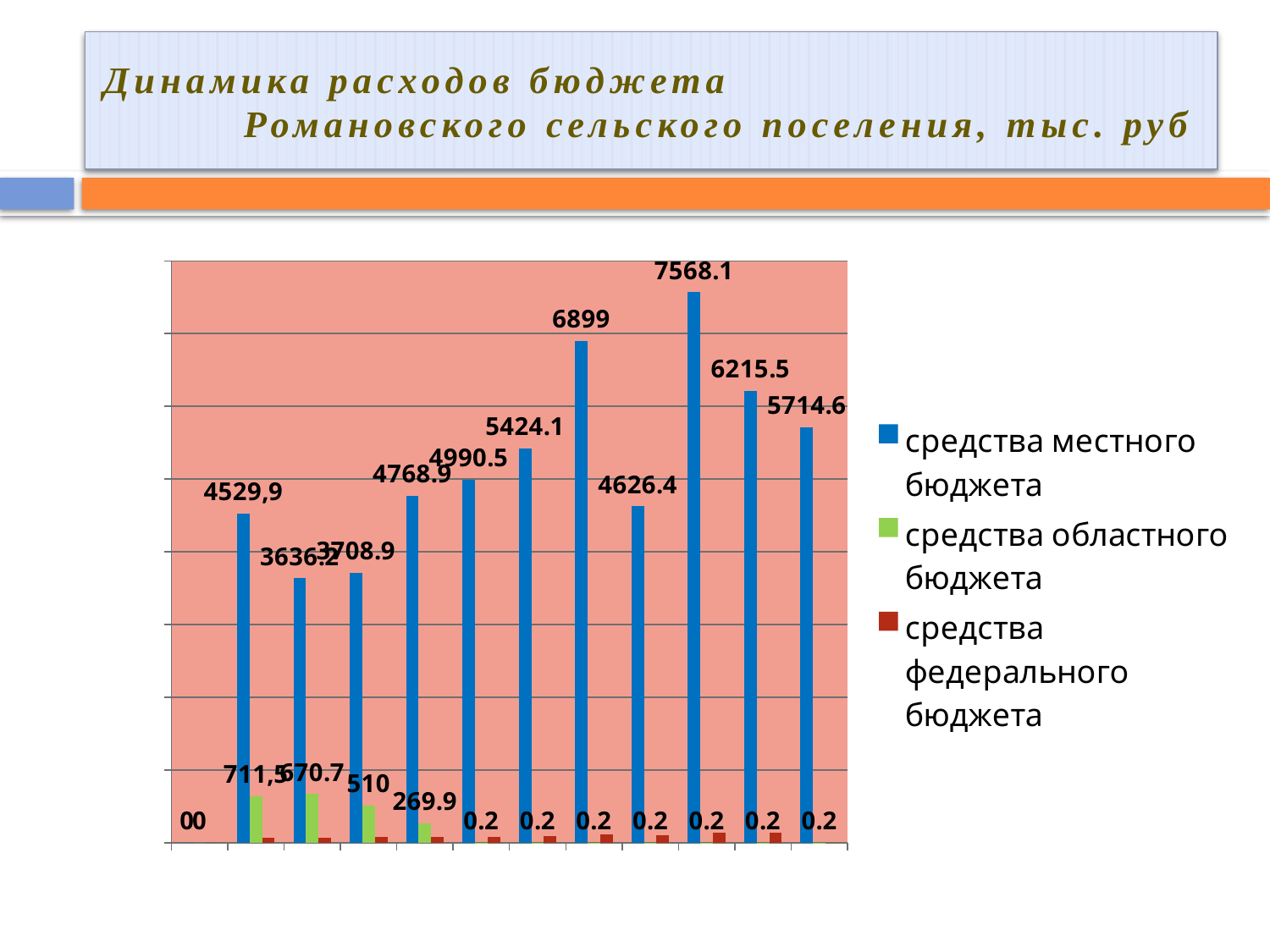
What is the value labelled on the first (leftmost) green bar for 'средства областного бюджета'? 711,5 What is the value labelled on the first (leftmost) blue bar for 'средства местного бюджета'? 4529,9 What is the difference between the highest blue bar (7568.1) and the blue bar immediately to its right (6215.5)? 1352.6 Which is larger for 'средства местного бюджета': the bar labelled 6899 or the bar labelled 6215.5? 6899 What is the value labelled on the last (rightmost) blue bar for 'средства местного бюджета'? 5714.6 Which series is shown in blue according to the legend? средства местного бюджета What is the lowest value labelled for the series 'средства местного бюджета'? 3636.2 How many series does the legend list? 3 What kind of chart is shown on the slide? bar chart What value is labelled on the last (rightmost) green bar for 'средства областного бюджета'? 0.2 How many blue bars (средства местного бюджета) are plotted in the chart? 11 What is the highest value labelled for the series 'средства местного бюджета'? 7568.1